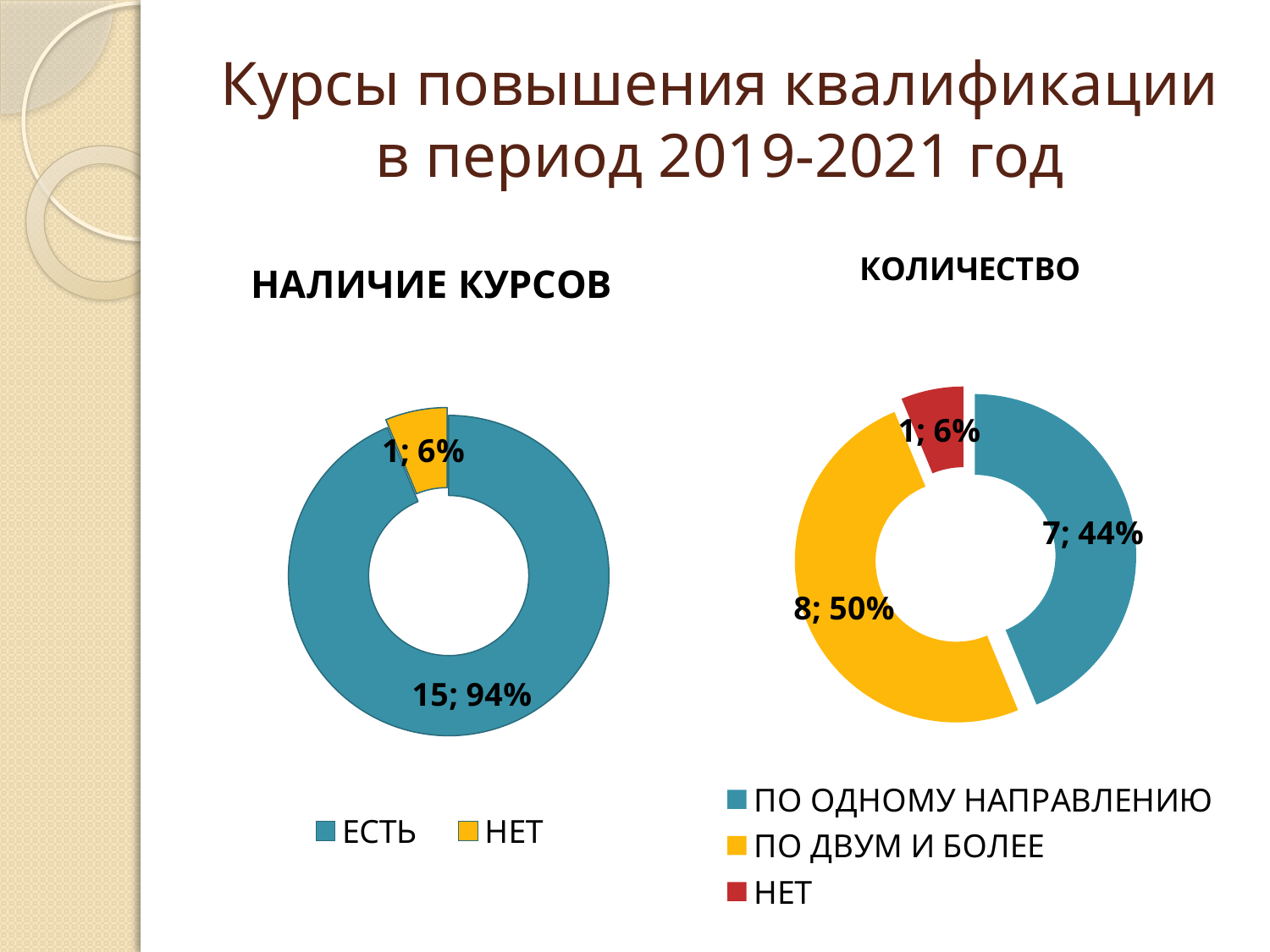
In the chart titled «КОЛИЧЕСТВО», how many categories does the legend list? 3 In the chart titled «КОЛИЧЕСТВО», which is larger: «ПО ОДНОМУ НАПРАВЛЕНИЮ» or «ПО ДВУМ И БОЛЕЕ»? ПО ДВУМ И БОЛЕЕ In the chart titled «НАЛИЧИЕ КУРСОВ», what is the difference between the counts for «ЕСТЬ» and «НЕТ»? 14 In the chart titled «КОЛИЧЕСТВО», which category has the smallest value? НЕТ In the chart titled «КОЛИЧЕСТВО», which category has the largest value? ПО ДВУМ И БОЛЕЕ In the chart titled «КОЛИЧЕСТВО», what share of the chart does «ПО ОДНОМУ НАПРАВЛЕНИЮ» represent? 44% In the chart titled «КОЛИЧЕСТВО», what value is shown for «ПО ДВУМ И БОЛЕЕ»? 8; 50% In the chart titled «КОЛИЧЕСТВО», what colour is the slice for «НЕТ»? Red In the chart titled «НАЛИЧИЕ КУРСОВ», what kind of chart is used? Doughnut chart In the chart titled «НАЛИЧИЕ КУРСОВ», what value is shown for «ЕСТЬ»? 15; 94% In the chart titled «НАЛИЧИЕ КУРСОВ», how many categories are shown? 2 In the chart titled «НАЛИЧИЕ КУРСОВ», what share of the chart does «НЕТ» represent? 6%